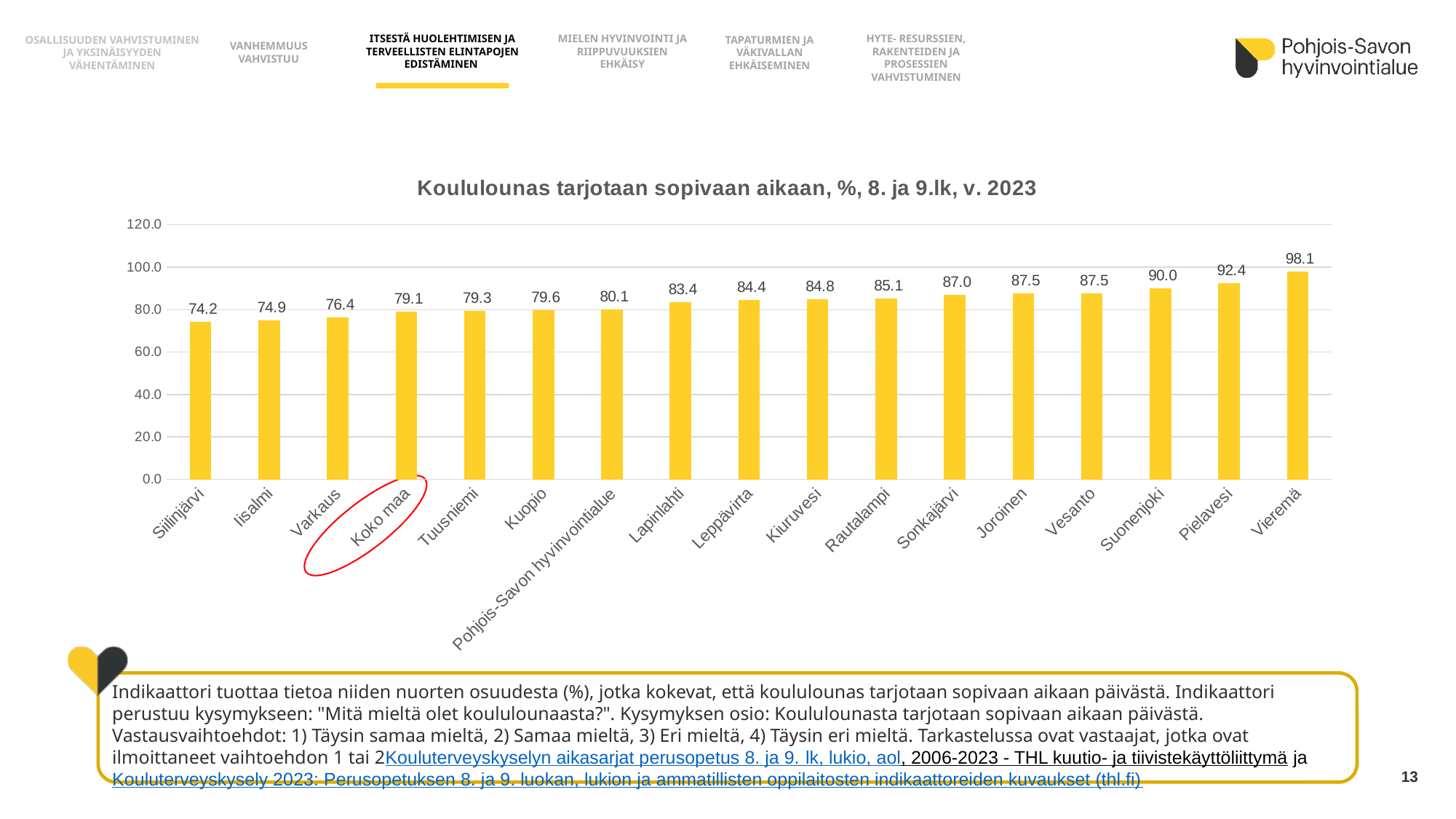
What is the title of the chart? Koululounas tarjotaan sopivaan aikaan, %, 8. ja 9.lk, v. 2023 How many categories are shown on the x axis? 17 What is the value for Pohjois-Savon hyvinvointialue? 80.1 What is the value for Koko maa? 79.1 What kind of chart is shown on the slide? bar chart Do the values rise or fall from left to right along the x axis? rise What is the value for Kuopio? 79.6 Is the value for Lapinlahti greater or less than 80.0? greater Which is larger, the value for Pielavesi or the value for Suonenjoki? Pielavesi Which category has the highest value? Vieremä Which category has the lowest value? Siilinjärvi What is the difference between the values for Vieremä and Siilinjärvi? 23.9